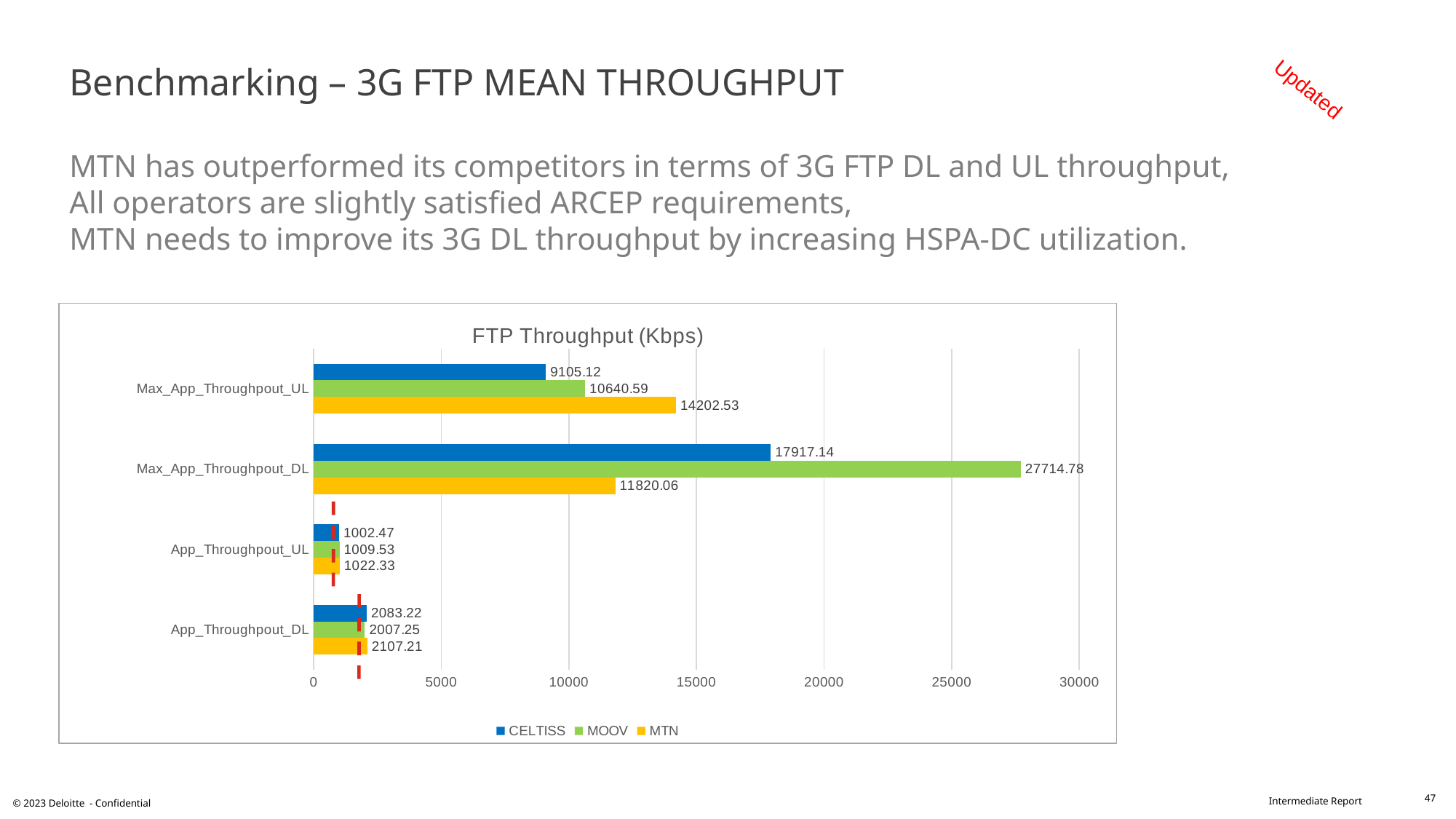
Which operator has the highest Max_App_Throughpout_DL? MOOV Which is larger for App_Throughpout_DL: the MTN value or the MOOV value? MTN What kind of chart is shown? Bar chart What is the difference between the MTN and CELTISS values for Max_App_Throughpout_UL? 5097.41 What is the MOOV value for Max_App_Throughpout_DL? 27714.78 What is the title of the chart? FTP Throughput (Kbps) How many categories are shown on the y axis? 4 What is the MTN value for Max_App_Throughpout_UL? 14202.53 What is the CELTISS value for App_Throughpout_DL? 2083.22 How many series does the legend list? 3 Which operator has the lowest Max_App_Throughpout_UL? CELTISS Is the CELTISS value for Max_App_Throughpout_DL greater or less than 15000? greater